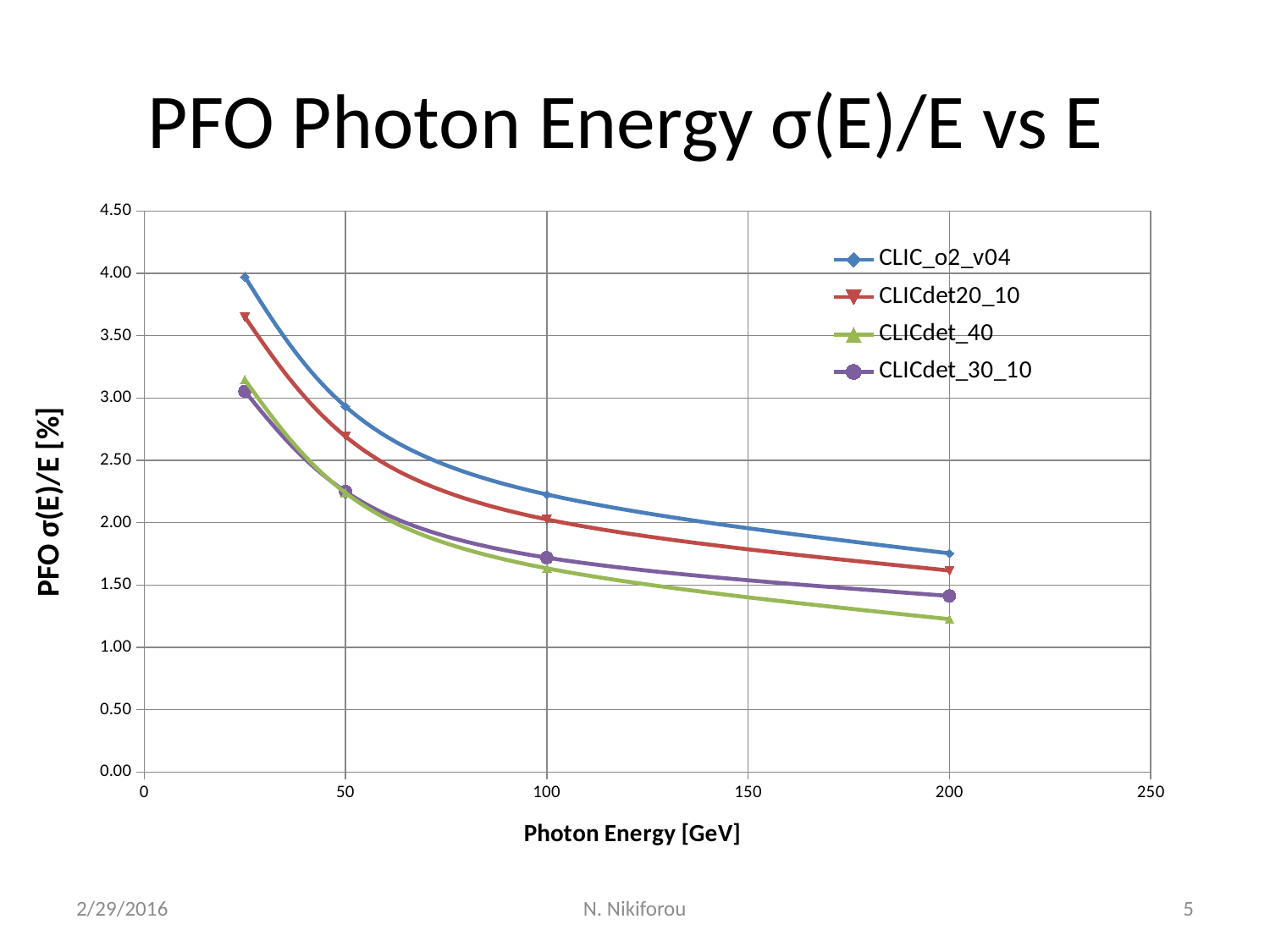
Is the value for CLIC_o2_v04 at 25 GeV greater or less than 3.50? greater Which series are listed in the legend? CLIC_o2_v04, CLICdet20_10, CLICdet_40, CLICdet_30_10 Which series has the lowest value at 200 GeV? CLICdet_40 Is the value for CLICdet20_10 at 100 GeV greater or less than 2.50? less What is the title of the x axis? Photon Energy [GeV] How do the PFO σ(E)/E values change as photon energy increases? They fall How many data points are plotted for the CLIC_o2_v04 series? 4 What kind of chart is shown on the slide? line chart How many series does the legend list? 4 Is the value for CLICdet_40 at 200 GeV greater or less than 1.50? less Which series has the highest value at 25 GeV? CLIC_o2_v04 At 200 GeV, which is larger: the value for CLIC_o2_v04 or the value for CLICdet_40? CLIC_o2_v04